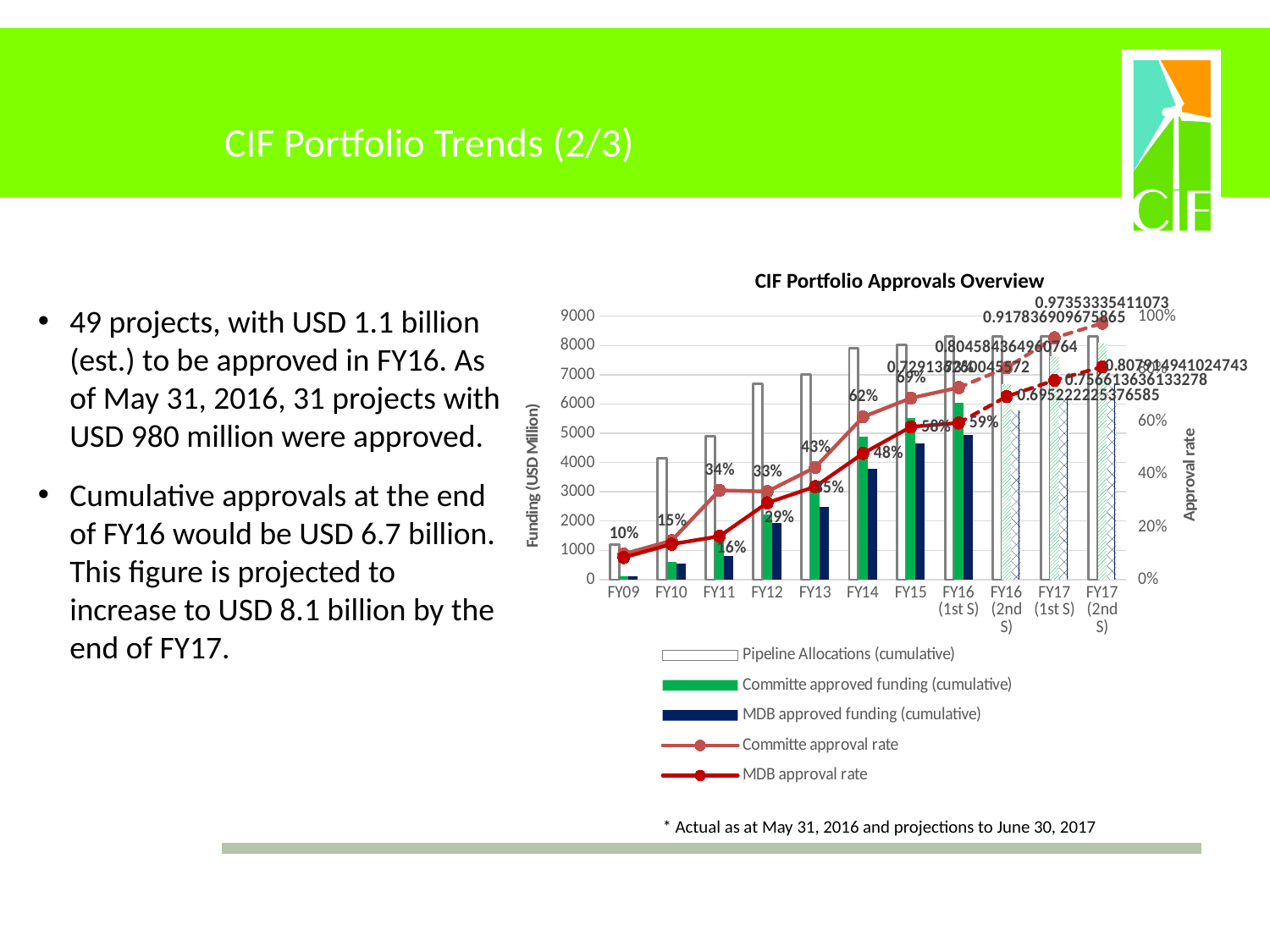
What is the Committee approval rate for FY09? 10% What kind of chart is this? Combination bar and line chart What is the title of the chart? CIF Portfolio Approvals Overview What is the MDB approval rate for FY15? 58% What is the Committee approval rate for FY14? 62% How many fiscal-year categories are shown on the x axis? 11 In FY14, which is larger: the Committee approval rate or the MDB approval rate? Committee approval rate How many series does the chart legend list? 5 In which period is the Committee approval rate highest? FY17 (2nd S) Is the Pipeline Allocations (cumulative) value for FY14 greater or less than 7000? greater In which period is the Committee approval rate lowest? FY09 By how many percentage points did the Committee approval rate increase from FY13 to FY14? 19 percentage points